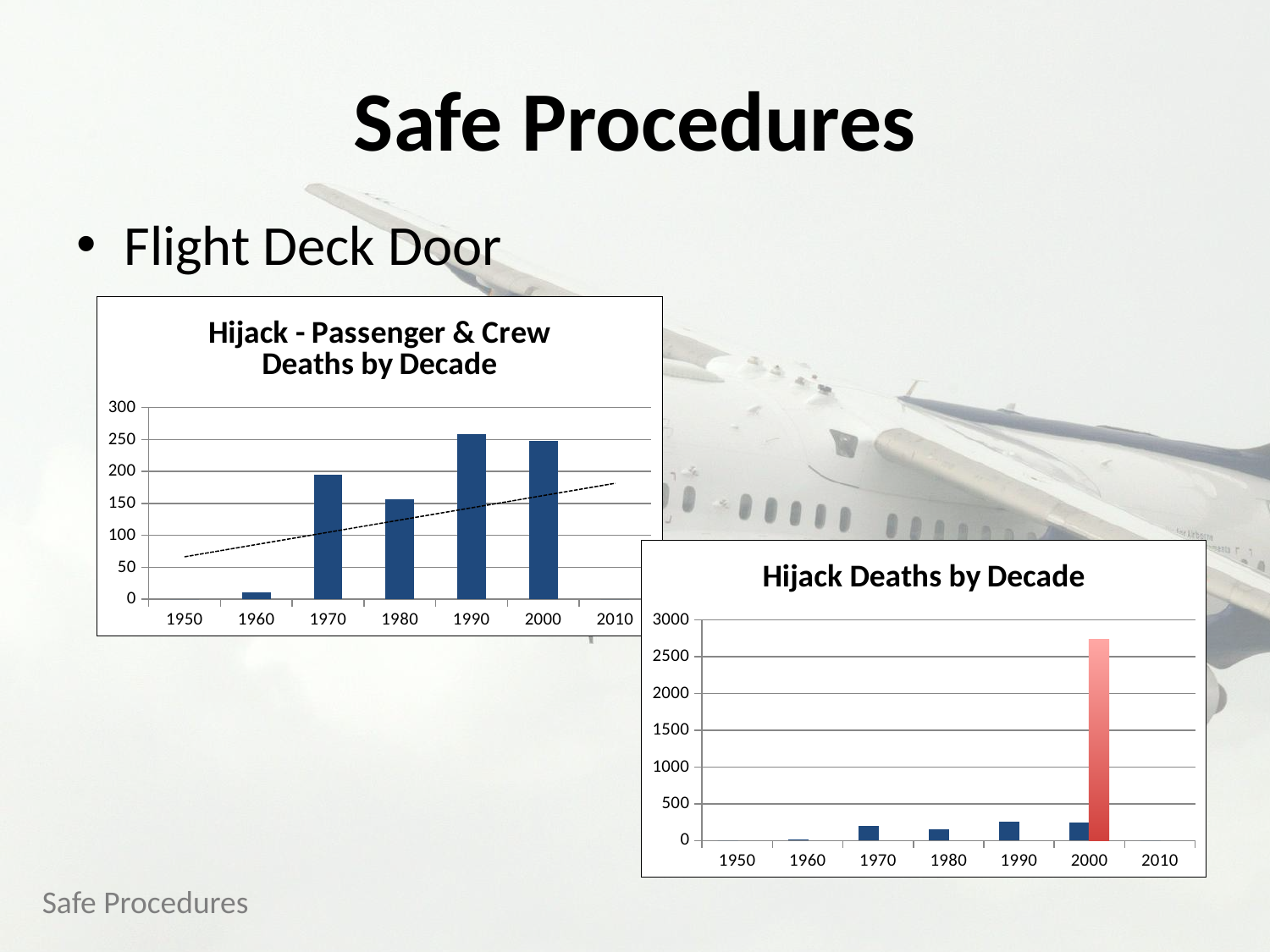
In the chart titled "Hijack Deaths by Decade", which decade has the tallest bar? 2000 In the chart titled "Hijack Deaths by Decade", what is the highest value shown on the vertical axis? 3000 In the chart titled "Hijack Deaths by Decade", what colour is the tallest bar? Red In the chart titled "Hijack - Passenger & Crew Deaths by Decade", which is larger, the value for 1970 or the value for 1980? 1970 In the chart titled "Hijack - Passenger & Crew Deaths by Decade", how many decade categories are shown on the x axis? 7 In the chart titled "Hijack - Passenger & Crew Deaths by Decade", what kind of chart is shown? Bar chart In the chart titled "Hijack - Passenger & Crew Deaths by Decade", is the value for 1960 greater or less than 50? less In the chart titled "Hijack - Passenger & Crew Deaths by Decade", which decade has the highest bar? 1990 In the chart titled "Hijack - Passenger & Crew Deaths by Decade", is the value for 1970 greater or less than 150? greater In the chart titled "Hijack Deaths by Decade", what kind of chart is shown? Bar chart In the chart titled "Hijack Deaths by Decade", is the red bar greater or less than 2500? greater In the chart titled "Hijack - Passenger & Crew Deaths by Decade", does the dashed trend line rise or fall from left to right? Rises